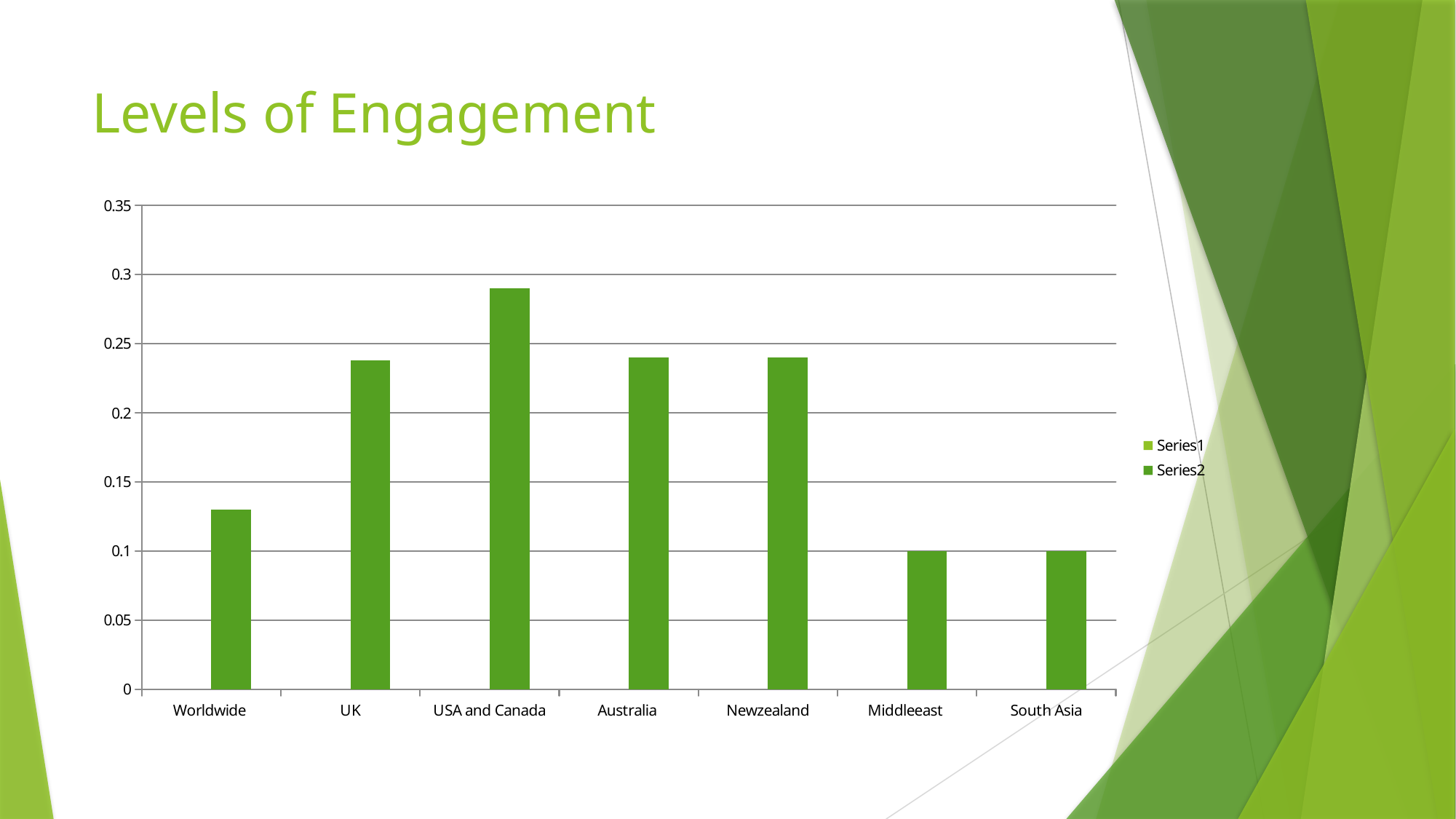
What is the title of the chart? Levels of Engagement Is the value for USA and Canada greater or less than 0.25? greater Which category has the highest value in the chart? USA and Canada Is the value for Worldwide greater or less than 0.1? greater What kind of chart is shown on the slide? bar chart Which has a larger value, Australia or Middleeast? Australia How many series does the chart's legend list? 2 What is the value for South Asia? 0.1 How many categories are shown on the x axis of the chart? 7 What is the value for Middleeast? 0.1 Which has a larger value, UK or Worldwide? UK Is the value for UK greater or less than 0.25? less